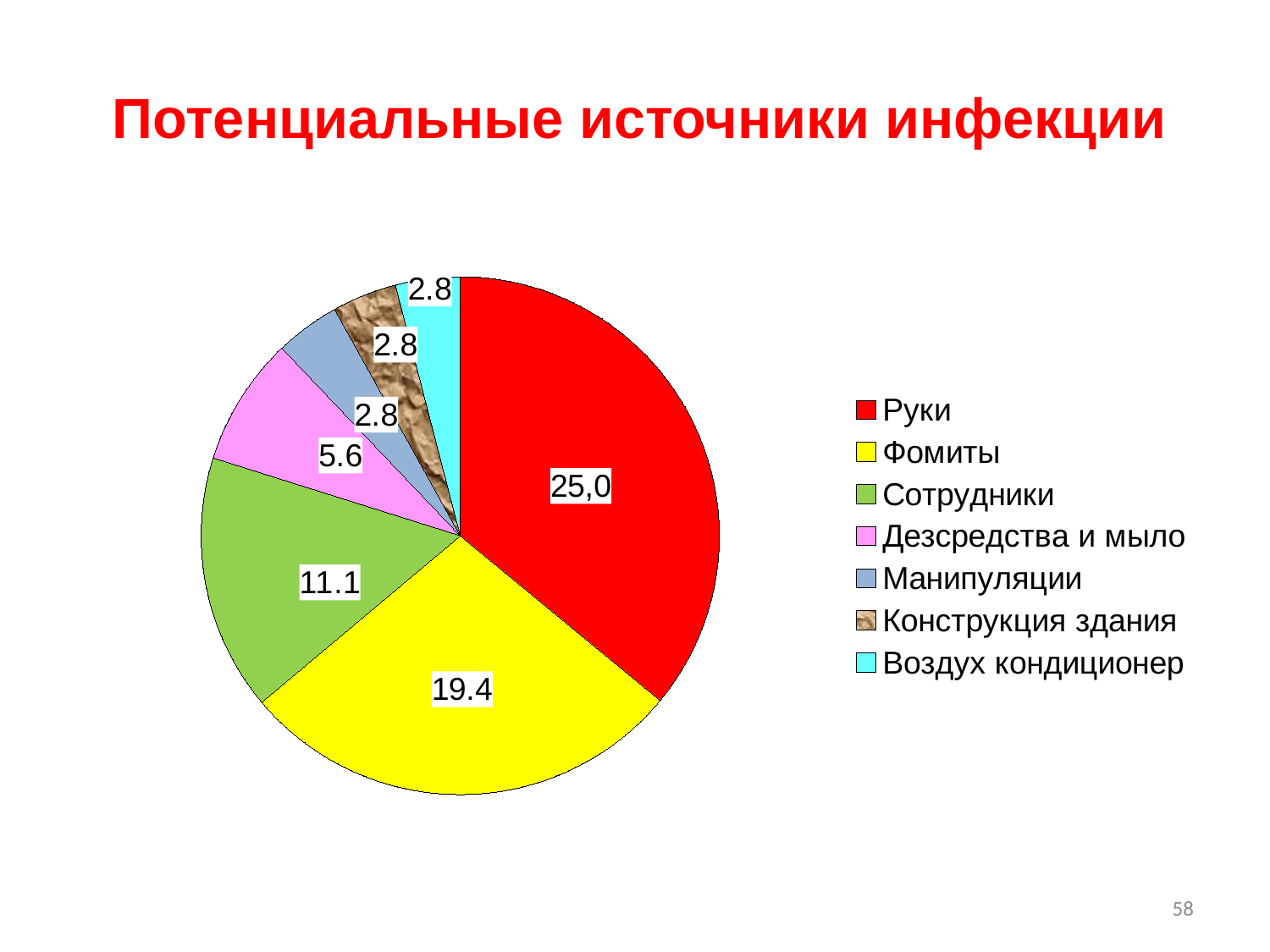
What is the value shown for Дезсредства и мыло? 5.6 What is the difference between the values for Руки and Фомиты? 5.6 How many categories does the legend list? 7 What is the title of the slide? Потенциальные источники инфекции Which is larger, the value for Сотрудники or the value for Дезсредства и мыло? Сотрудники What type of chart is shown on the slide? pie chart What is the value shown for Фомиты? 19.4 What is the value shown for Сотрудники? 11.1 What is the smallest value labelled on the pie chart? 2.8 What is the value shown for Руки? 25,0 Which category has the largest slice of the pie? Руки What is the value shown for Воздух кондиционер? 2.8